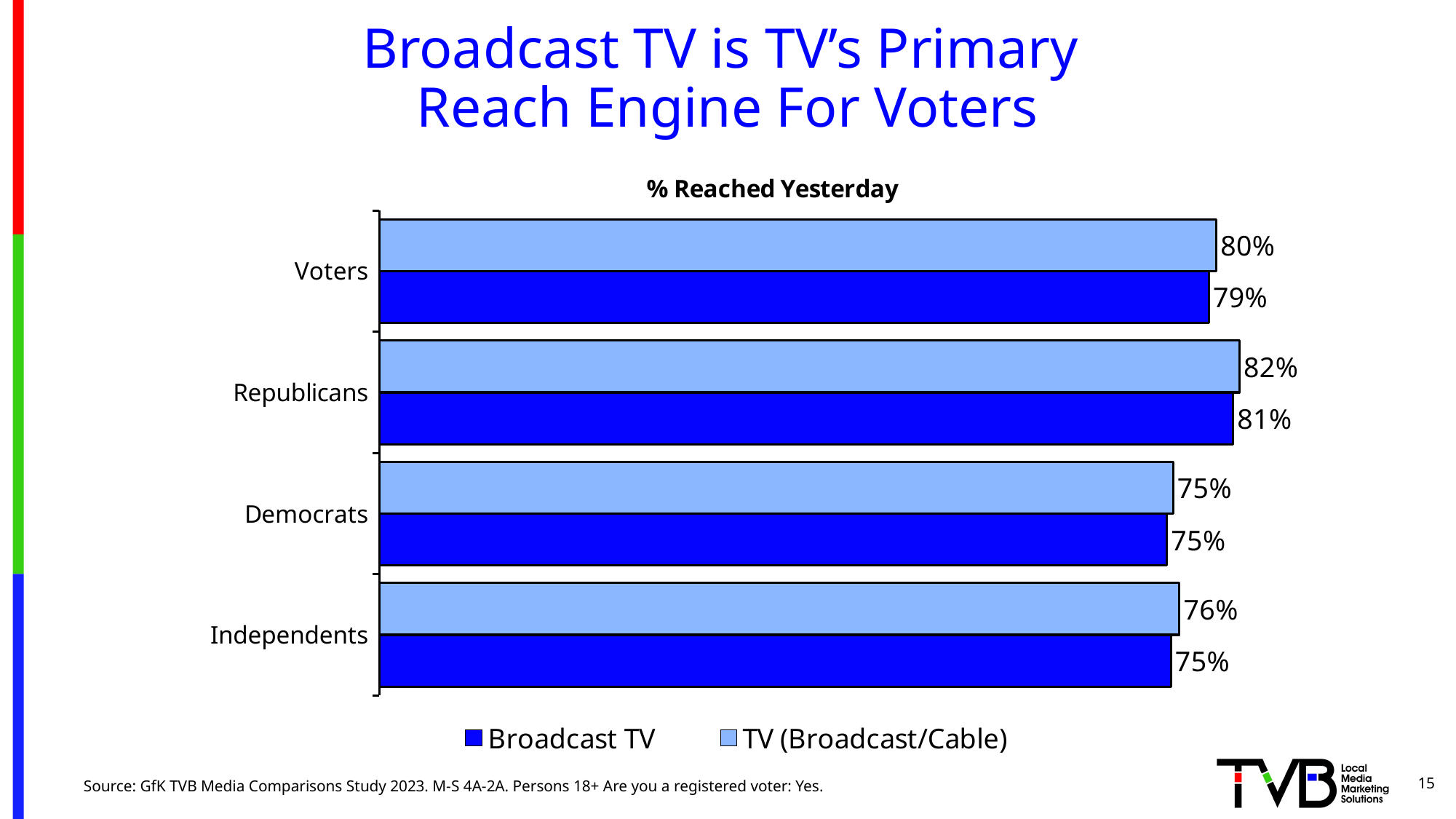
What is the Broadcast TV value for Republicans? 81% How many categories are shown on the chart? 4 What is the difference between the Broadcast TV values for Republicans and Democrats? 6% What is the difference between the TV (Broadcast/Cable) and Broadcast TV values for Voters? 1% How many series does the legend list? 2 Which category has the highest TV (Broadcast/Cable) value? Republicans Which category has the highest Broadcast TV value? Republicans What kind of chart is shown on the slide? Bar chart What is the TV (Broadcast/Cable) value for Voters? 80% What is the TV (Broadcast/Cable) value for Democrats? 75% What is the title of the chart? % Reached Yesterday What is the Broadcast TV value for Independents? 75%